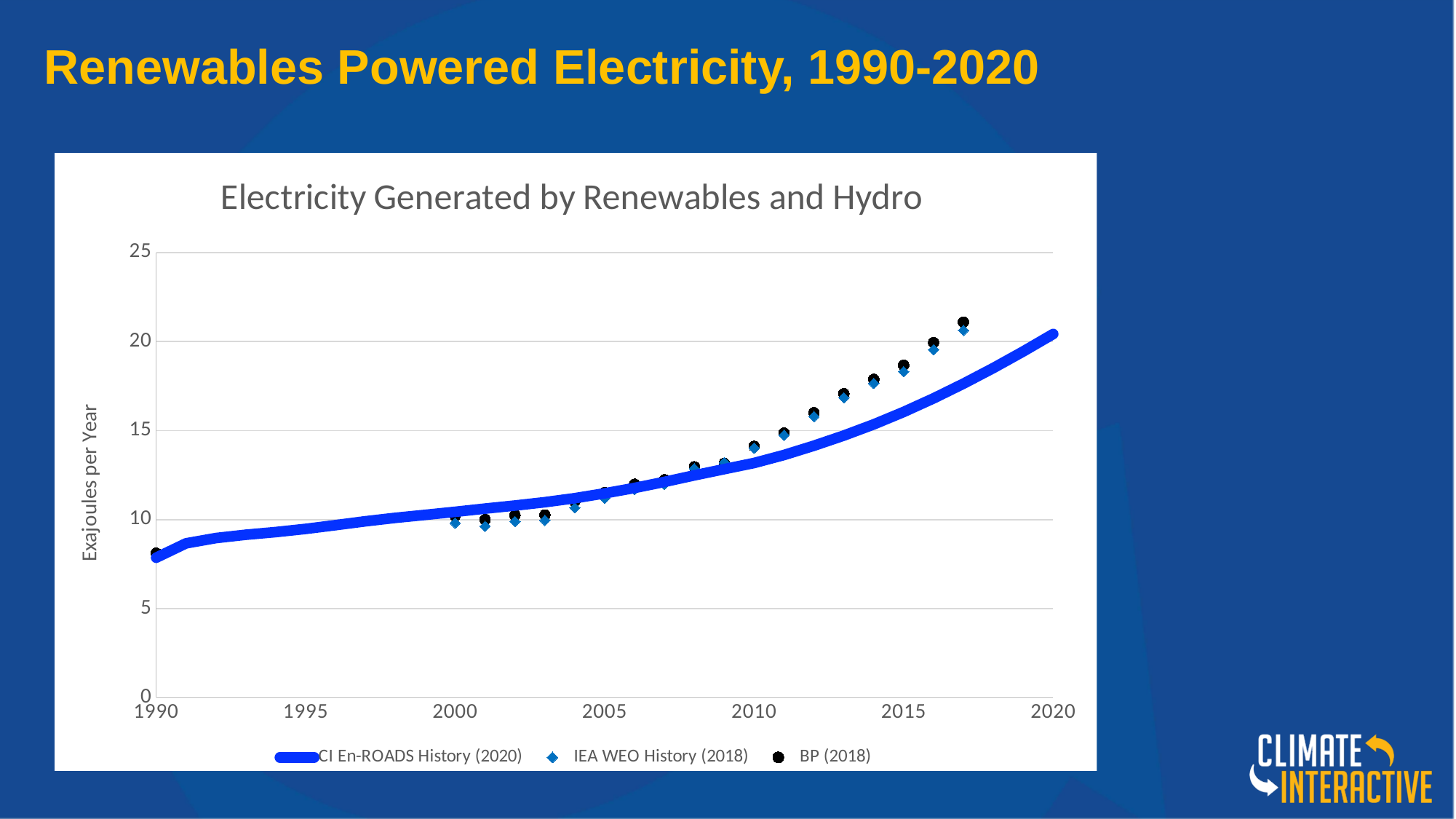
Is the CI En-ROADS History (2020) value in 2010 greater or less than 10? greater Is the CI En-ROADS History (2020) value in 1990 greater or less than 10? less How many series does the legend list? 3 Does the CI En-ROADS History (2020) series rise or fall from 1990 to 2020? rise What is the label on the vertical axis? Exajoules per Year What is the title of the chart? Electricity Generated by Renewables and Hydro In 2017, which is higher: the BP (2018) value or the CI En-ROADS History (2020) value? BP (2018) Is the CI En-ROADS History (2020) value in 2020 greater or less than 15? greater What kind of chart is shown on the slide? line chart How many year labels are shown on the x axis? 7